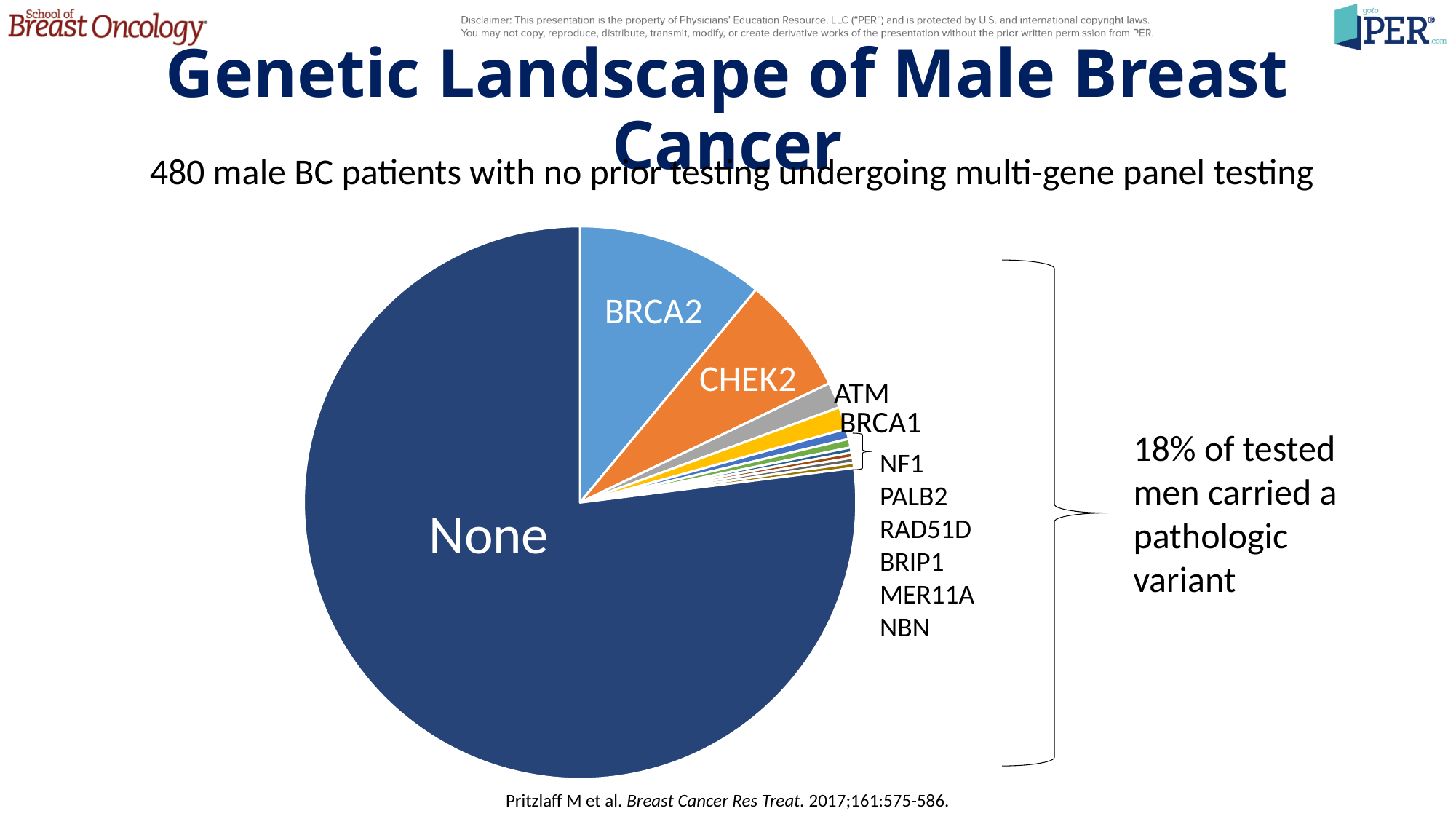
According to the slide, what percentage of tested men carried a pathologic variant? 18% What kind of chart is shown on the slide? pie chart How many male BC patients underwent multi-gene panel testing according to the slide? 480 How many categories are labelled on the pie chart? 11 Which slice is larger, None or BRCA2? None Which gene has the largest slice among the pathologic variants (excluding None)? BRCA2 Which slice is larger, BRCA1 or None? None Which slice is larger, BRCA2 or CHEK2? BRCA2 Which category has the largest slice of the pie chart? None